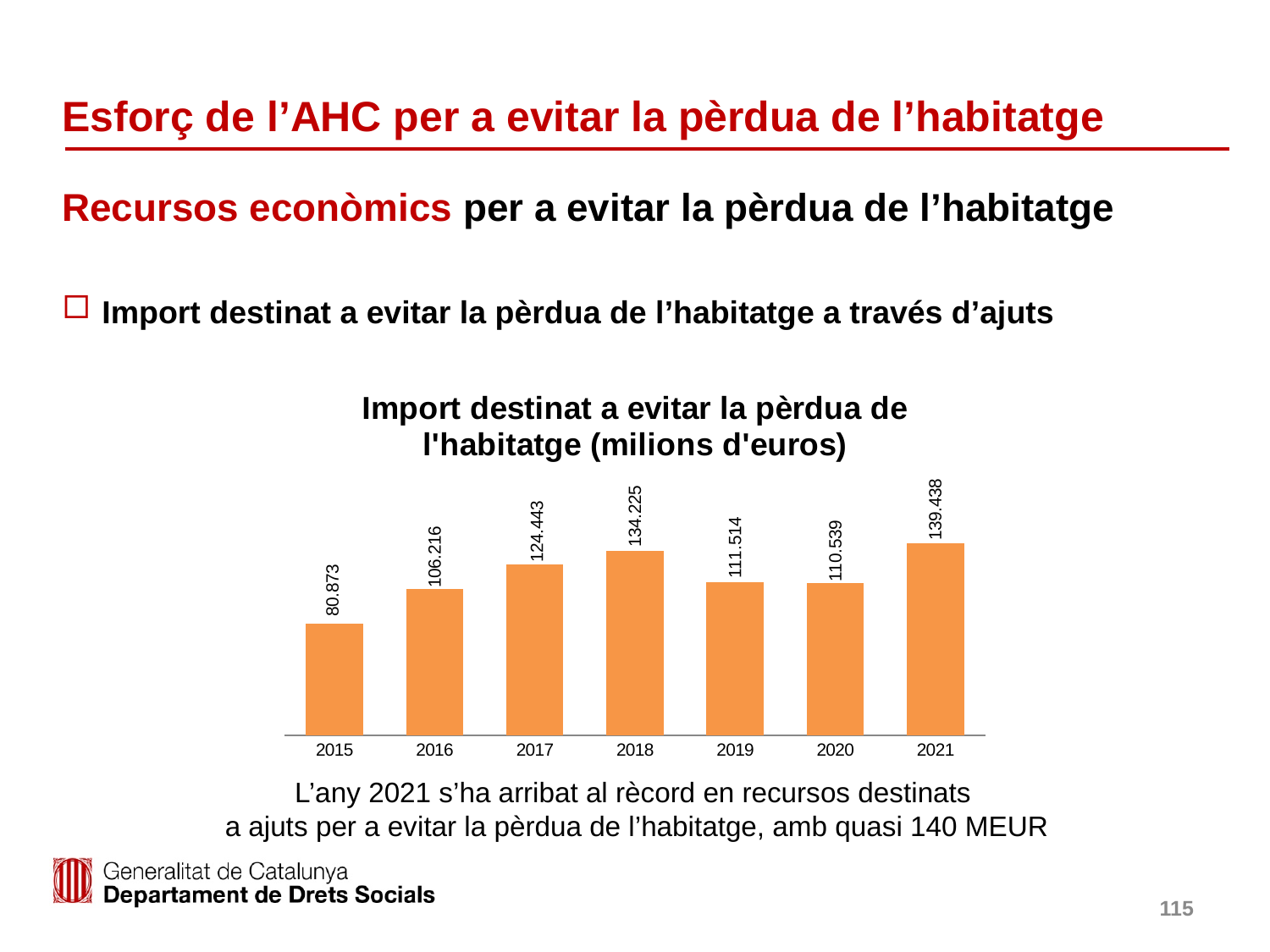
What is the value for 2015 in the chart? 80.873 What is the value for 2019 in the chart? 111.514 What is the difference between the values for 2021 and 2015? 58.565 What kind of chart is shown on the slide? Bar chart What is the difference between the values for 2018 and 2017? 9.782 What is the value for 2018 in the chart? 134.225 Which is larger, the value for 2016 or the value for 2019? 2019 Which year has the lowest value in the chart? 2015 Which year has the highest value in the chart? 2021 Do the values rise or fall from 2015 to 2018? Rise How many years are shown on the x axis of the chart? 7 What is the value for 2021 in the chart "Import destinat a evitar la pèrdua de l'habitatge (milions d'euros)"? 139.438